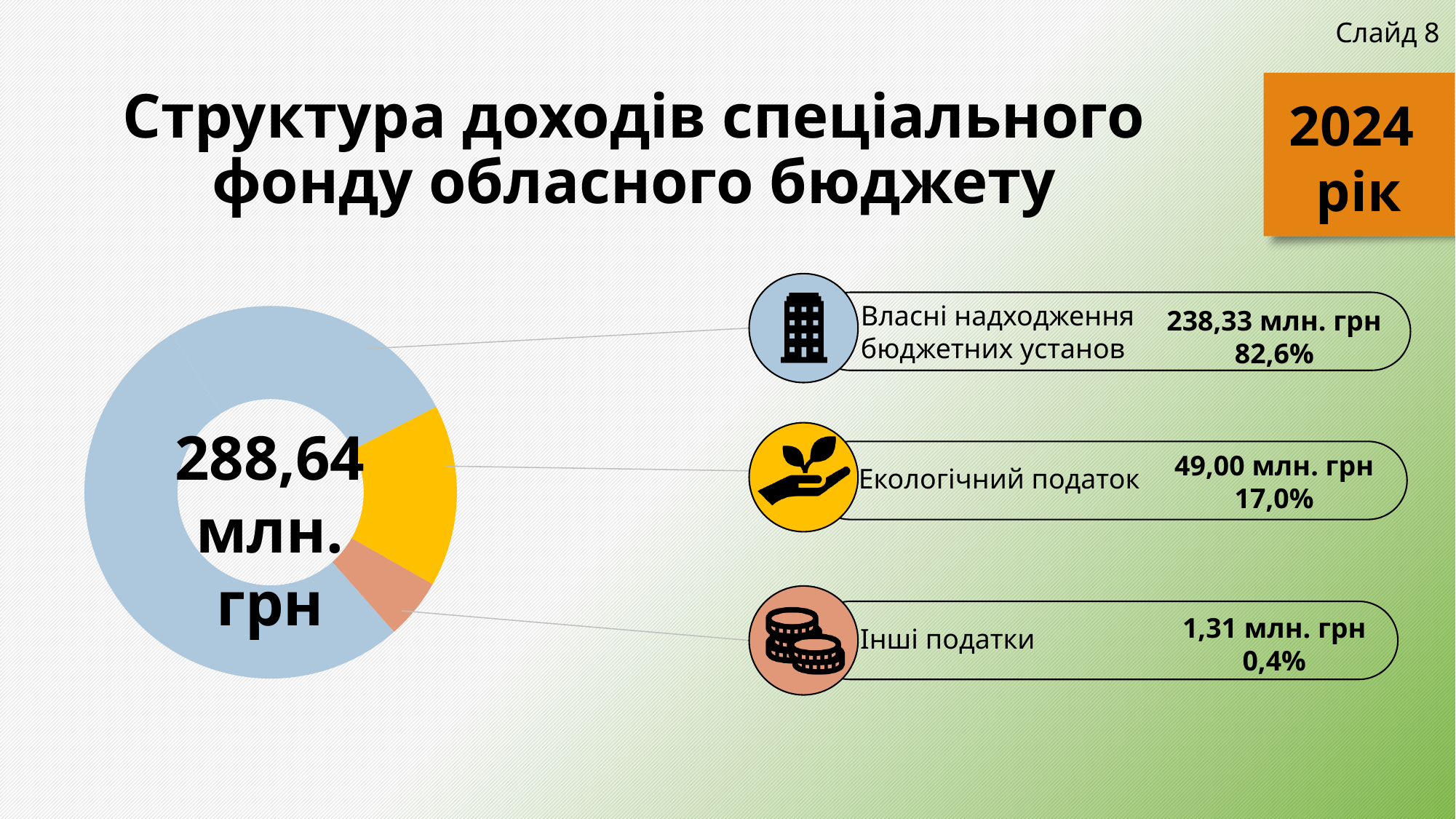
What total is shown in the centre of the donut chart? 288,64 млн. грн What kind of chart is shown on the slide? Pie chart (donut) Which is larger, Екологічний податок or Інші податки? Екологічний податок What is the value for Власні надходження бюджетних установ? 238,33 млн. грн What is the value for Інші податки? 1,31 млн. грн How many categories does the chart show? 3 What is the difference between Екологічний податок and Інші податки? 47,69 млн. грн Which category has the largest value? Власні надходження бюджетних установ Which category has the smallest value? Інші податки What is the value for Екологічний податок? 49,00 млн. грн What share of the chart does Екологічний податок represent? 17,0% What share of the chart does Власні надходження бюджетних установ represent? 82,6%